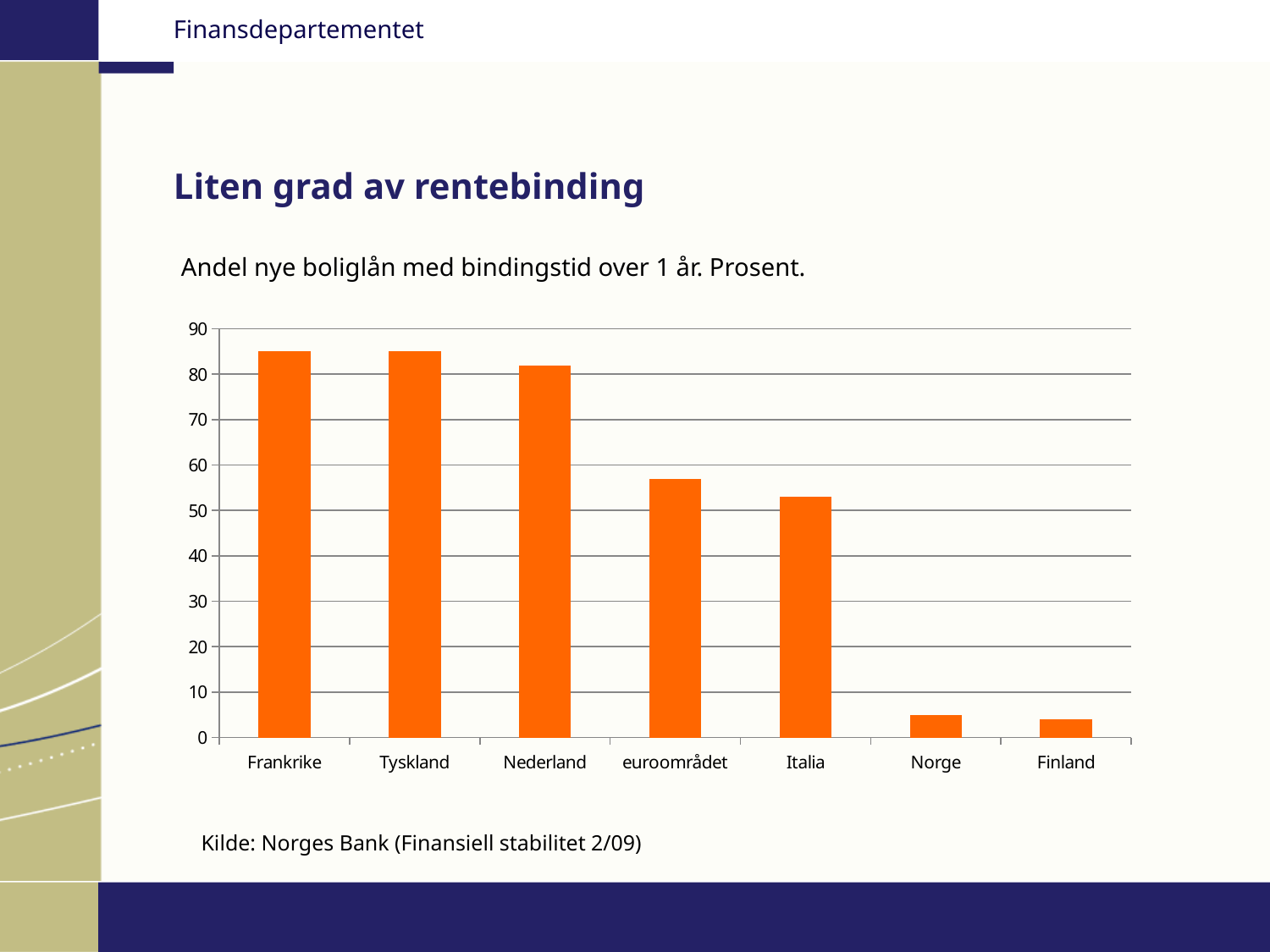
Which has the larger value, Norge or euroområdet? euroområdet Is the value for Norge greater or less than 10? less Is the value for Finland greater or less than 10? less What is the title of the slide above the chart? Liten grad av rentebinding What kind of chart is shown on the slide? bar chart Do the bar values rise or fall from left to right along the x axis? fall Is the value for Italia greater or less than 50? greater Which has the larger value, Nederland or Italia? Nederland How many countries or regions are shown on the x axis of the chart? 7